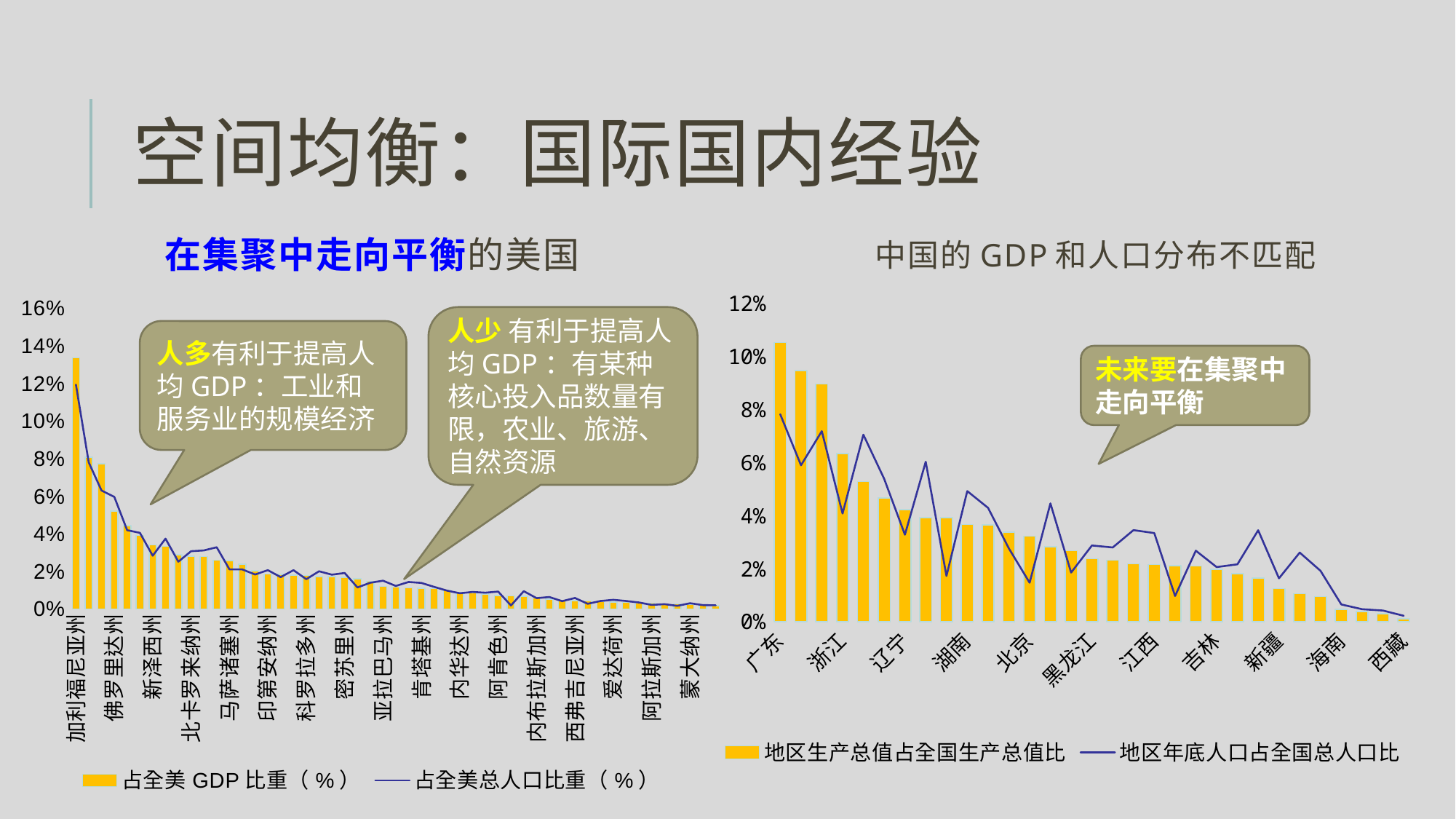
How many series does the legend of the right chart list? 2 What are the two legend entries of the left chart? 占全美GDP比重（%） and 占全美总人口比重（%） In the right chart (中国的GDP和人口分布不匹配), which province has the highest GDP share bar? 广东 In the left chart, is the GDP share bar for 加利福尼亚州 greater or less than 12%? greater In the right chart, which province has a larger GDP share bar, 广东 or 西藏? 广东 In the right chart (中国的GDP和人口分布不匹配), which labelled province has the lowest GDP share bar? 西藏 In the right chart, which is larger for 广东: the GDP share bar or the population share line? the GDP share bar (地区生产总值占全国生产总值比) In the right chart, is the GDP share bar for 西藏 greater or less than 2%? less In the right chart, do the GDP share bars rise or fall from left to right along the x axis? fall In the right chart, is the GDP share bar for 广东 greater or less than 10%? greater What kind of chart is the left chart (在集聚中走向平衡的美国)? a bar chart combined with a line In the left chart (在集聚中走向平衡的美国), which state has the highest GDP share bar? 加利福尼亚州